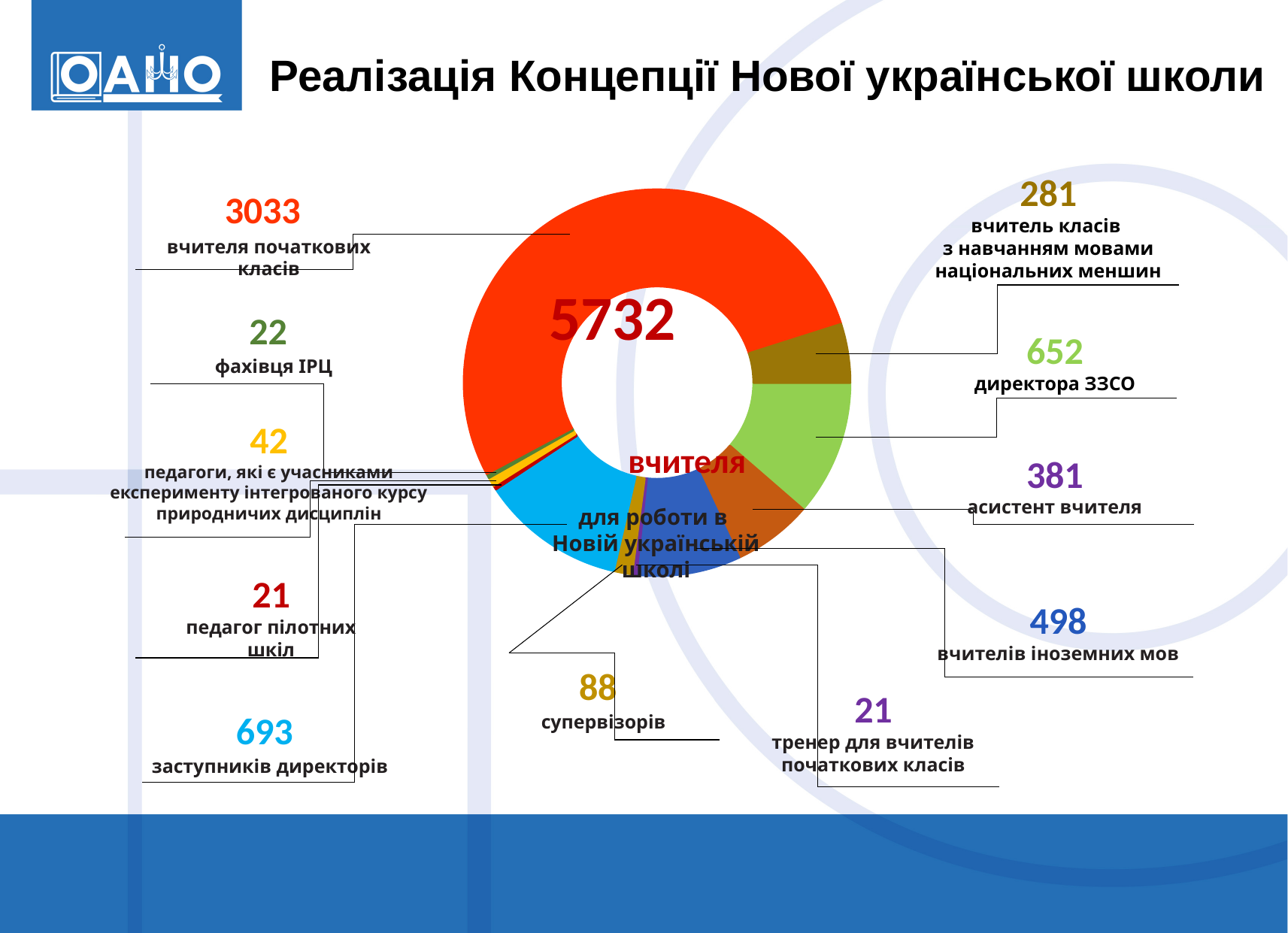
How many categories are shown on the chart? 11 What is the difference between the values for асистент вчителя and вчитель класів з навчанням мовами національних меншин? 100 What kind of chart is shown on the slide? Donut (pie) chart What is the value for супервізорів? 88 What is the value for директора ЗЗСО? 652 What is the value for вчителів іноземних мов? 498 What is the title of the slide? Реалізація Концепції Нової української школи What is the difference between the values for вчителя початкових класів and заступників директорів? 2340 What is the total number shown in the centre of the donut chart? 5732 Which is larger: заступників директорів or директора ЗЗСО? заступників директорів Which category has the largest value on the chart? вчителя початкових класів How many вчителя початкових класів are shown on the chart? 3033